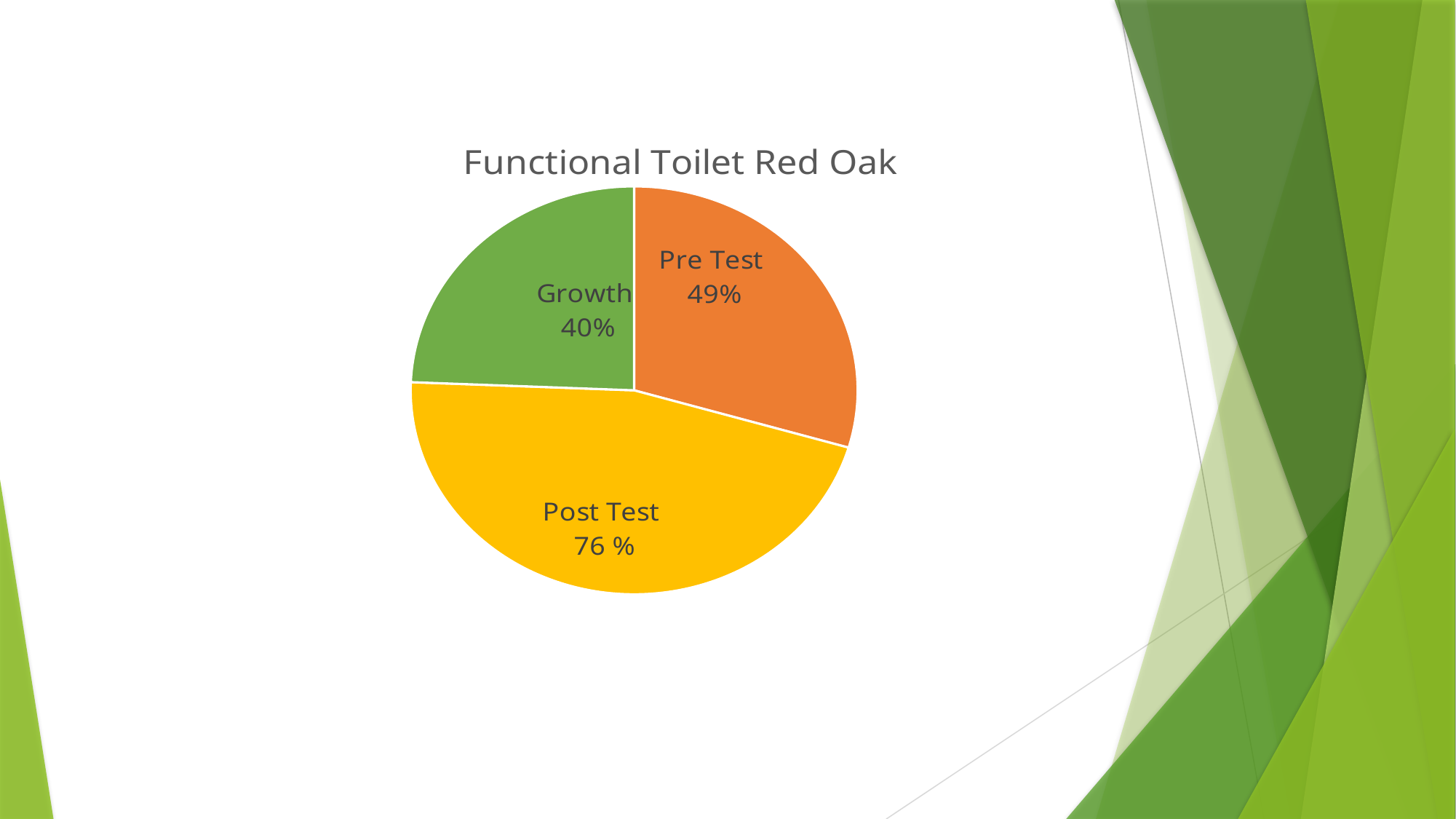
Which slice has the largest value? Post Test What value is labelled on the Pre Test slice? 49% What is the difference between the Post Test value and the Pre Test value? 27 percentage points What value is labelled on the Post Test slice? 76 % Which slice has the smallest value? Growth What value is labelled on the Growth slice? 40% What is the difference between the Pre Test value and the Growth value? 9 percentage points How many slices does the pie chart have? 3 What colour is the Post Test slice? yellow What is the title of the pie chart? Functional Toilet Red Oak Which is larger, the Pre Test value or the Growth value? Pre Test What kind of chart is shown on the slide? pie chart